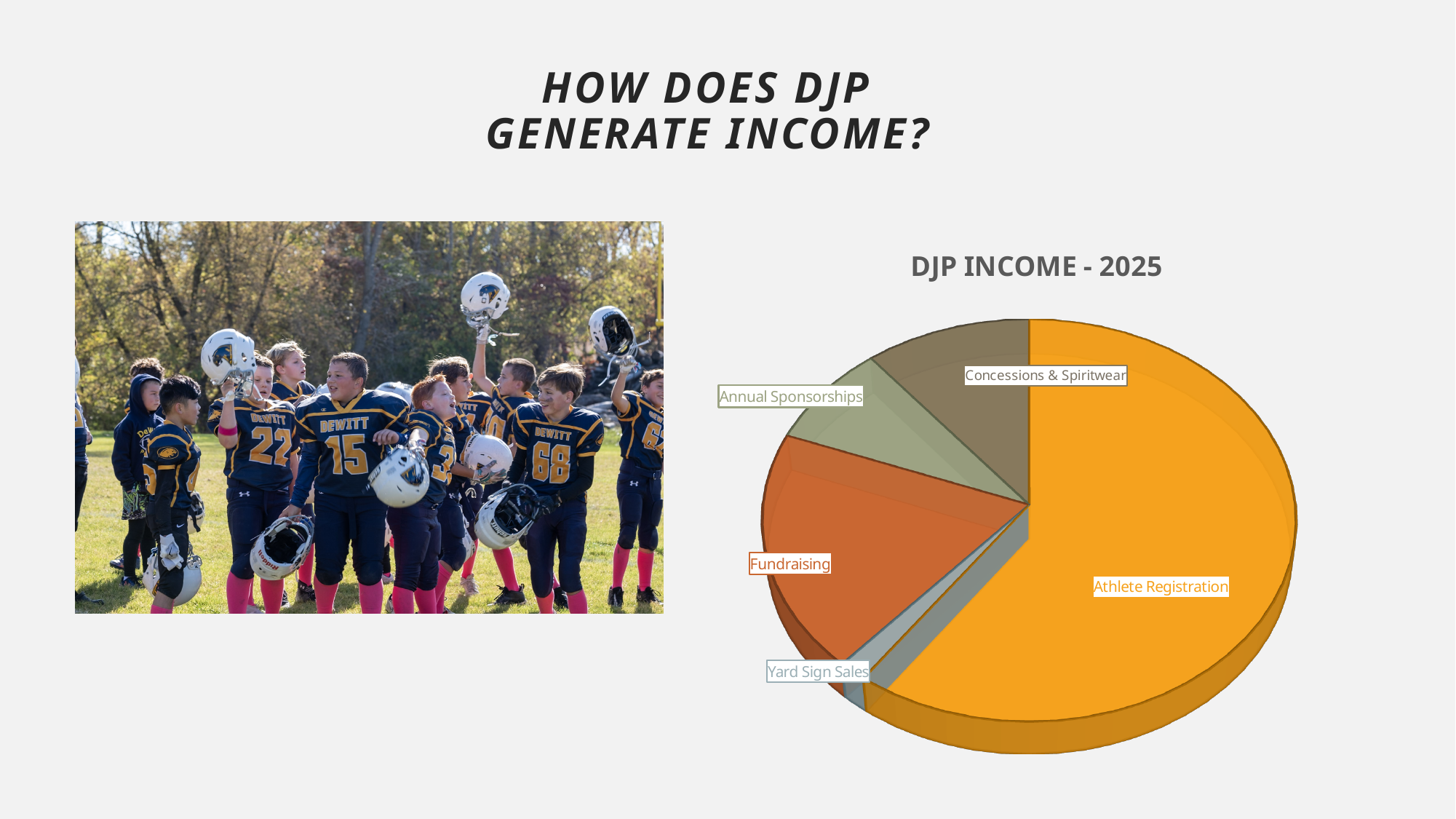
Which income source has the smallest slice of the pie? Yard Sign Sales Which slice is larger, Athlete Registration or Concessions & Spiritwear? Athlete Registration What colour is the Athlete Registration slice? orange How many slices does the pie chart have? 5 What kind of chart is shown on the slide? pie chart Which income source is the second-largest slice of the pie? Fundraising Which slice is larger, Fundraising or Annual Sponsorships? Fundraising Which income source has the largest slice of the pie? Athlete Registration What is the title of the chart? DJP INCOME - 2025